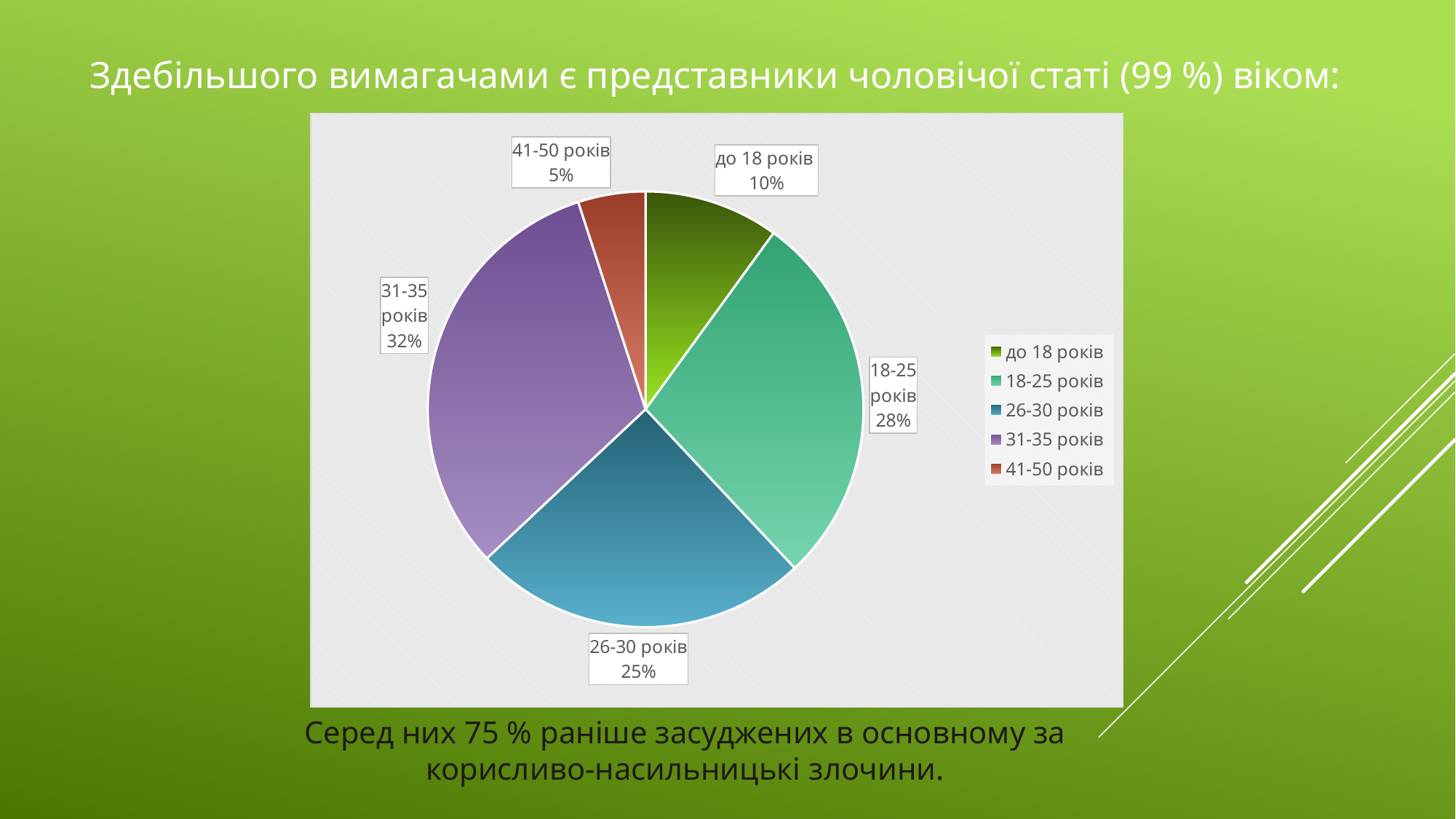
What is the difference in percentage points between the 31-35 років slice and the 41-50 років slice? 27 Which age group has the smallest slice of the pie? 41-50 років Which age group has the largest slice of the pie? 31-35 років What is the value shown for the 26-30 років slice? 25% What kind of chart is shown on the slide? pie chart What share of the pie does the 18-25 років slice represent? 28% What colour is the 31-35 років slice in the pie chart? purple How many slices does the pie chart have? 5 What is the value shown for the 41-50 років slice? 5% What is the value shown for the до 18 років slice? 10% What share of the pie does the 31-35 років slice represent? 32% Which slice is larger: 18-25 років or 26-30 років? 18-25 років